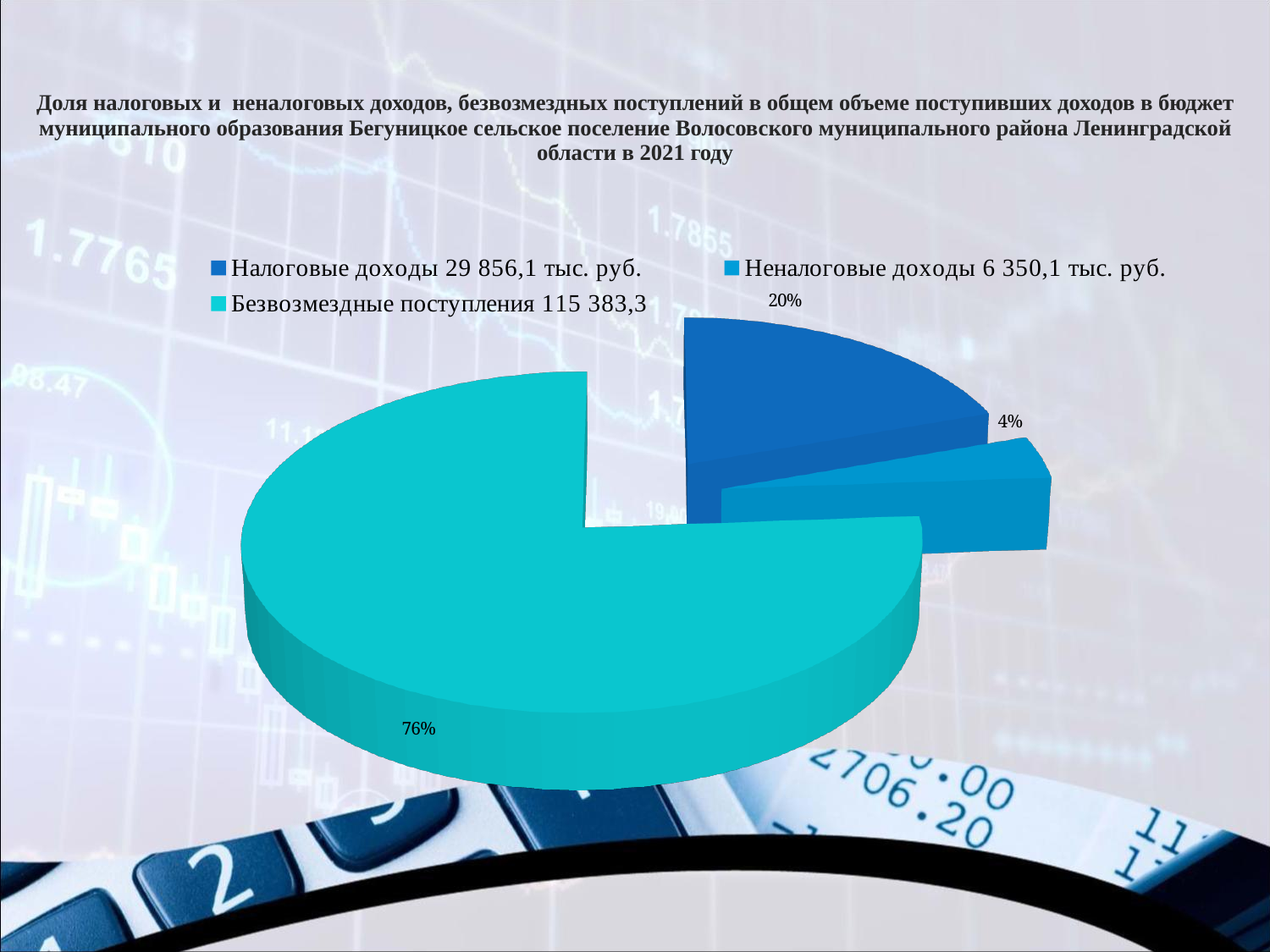
What amount in тыс. руб. is given in the legend for Налоговые доходы? 29 856,1 тыс. руб. What share of the pie is labelled for Неналоговые доходы? 4% Which category has the largest slice of the pie? Безвозмездные поступления Which is larger: the share for Налоговые доходы or the share for Неналоговые доходы? Налоговые доходы What share of the pie is labelled for Налоговые доходы? 20% What share of the pie is labelled for Безвозмездные поступления? 76% Which category has the smallest slice of the pie? Неналоговые доходы What amount is given in the legend for Неналоговые доходы? 6 350,1 тыс. руб. What is the difference in percentage points between the share for Безвозмездные поступления and the share for Налоговые доходы? 56 percentage points How many entries does the legend list? 3 How many slices does the pie chart have? 3 What kind of chart is shown on the slide? pie chart